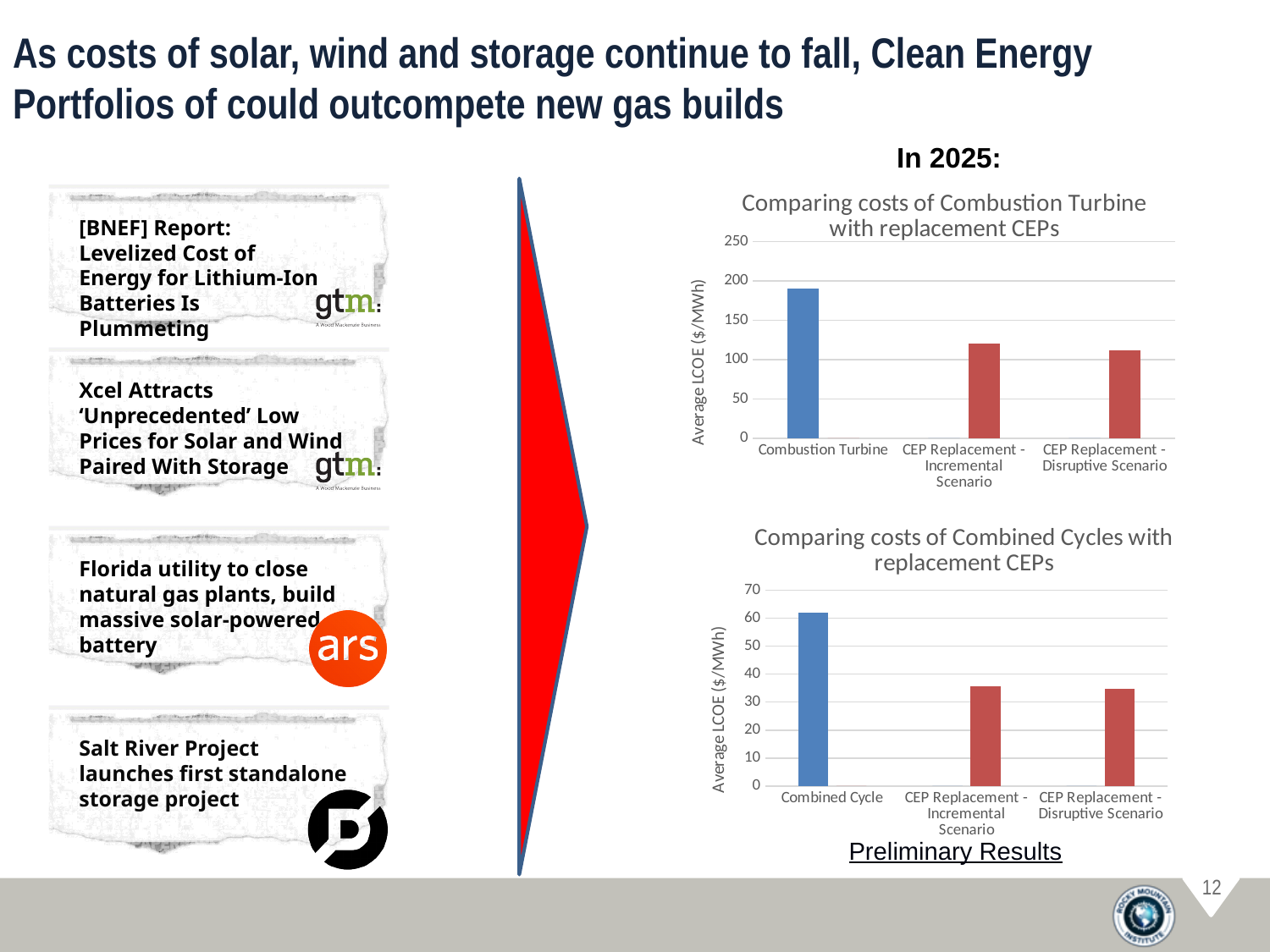
In the 'Comparing costs of Combined Cycles with replacement CEPs' chart, is the value for Combined Cycle greater or less than 50? greater What is the title of the bottom chart on the slide? Comparing costs of Combined Cycles with replacement CEPs In the 'Comparing costs of Combustion Turbine with replacement CEPs' chart, which category has the highest value? Combustion Turbine In the 'Comparing costs of Combustion Turbine with replacement CEPs' chart, is the value for CEP Replacement - Incremental Scenario greater or less than 150? less In the 'Comparing costs of Combined Cycles with replacement CEPs' chart, is the value for CEP Replacement - Incremental Scenario greater or less than 50? less What is the y-axis label of the 'Comparing costs of Combined Cycles with replacement CEPs' chart? Average LCOE ($/MWh) In the 'Comparing costs of Combined Cycles with replacement CEPs' chart, which is larger: Combined Cycle or CEP Replacement - Incremental Scenario? Combined Cycle In the 'Comparing costs of Combustion Turbine with replacement CEPs' chart, which is larger: Combustion Turbine or CEP Replacement - Disruptive Scenario? Combustion Turbine How many categories are shown in the 'Comparing costs of Combustion Turbine with replacement CEPs' chart? 3 In the 'Comparing costs of Combined Cycles with replacement CEPs' chart, which category has the highest value? Combined Cycle What type of chart is the 'Comparing costs of Combustion Turbine with replacement CEPs' chart? bar chart